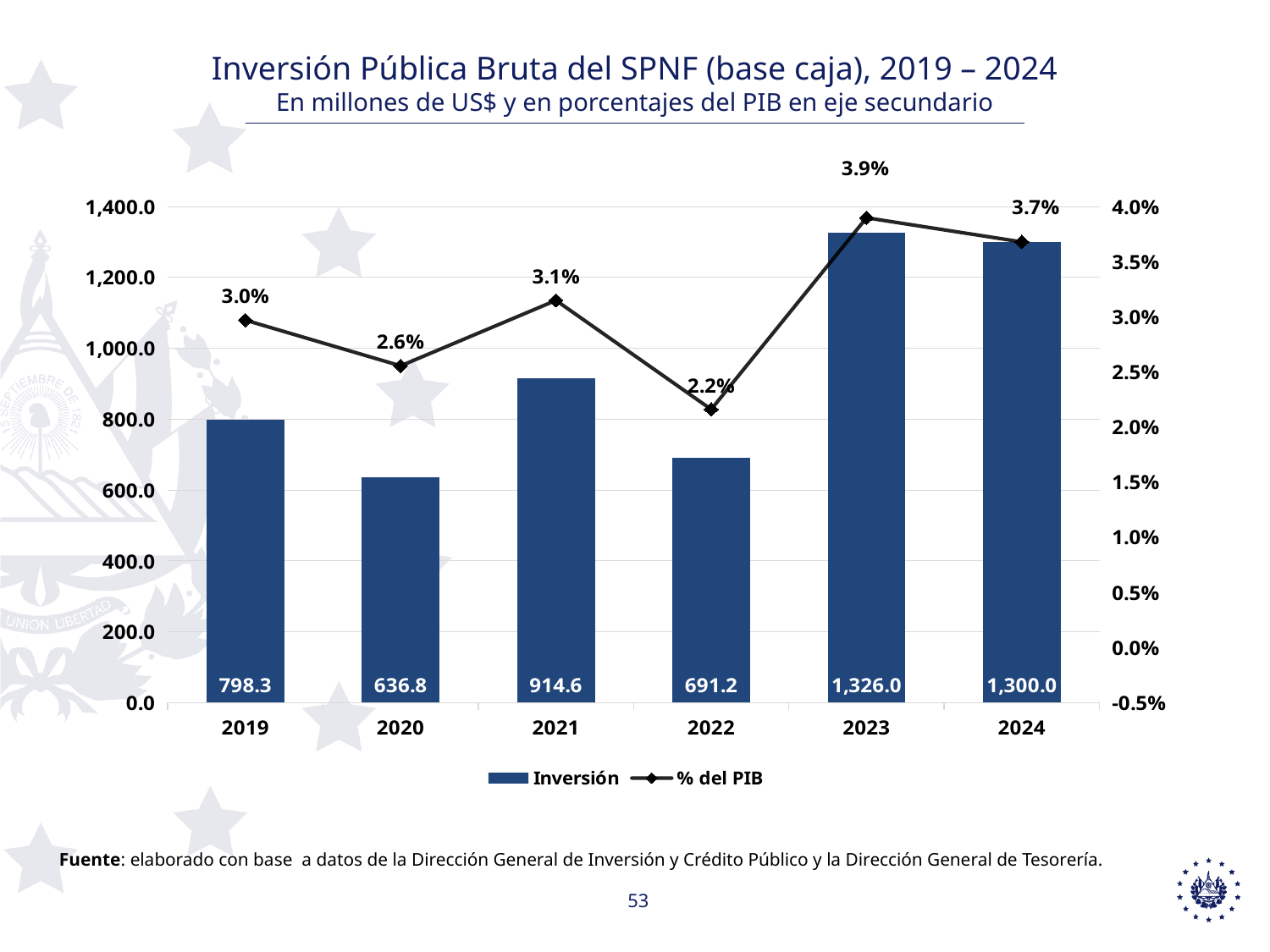
What is the difference between the Inversión values for 2023 and 2024? 26.0 How many series does the legend list? 2 Which year has the lowest % del PIB value? 2022 How many years are shown on the x axis? 6 What is the title of the chart? Inversión Pública Bruta del SPNF (base caja), 2019 – 2024 What is the % del PIB value for 2022? 2.2% What is the Inversión value for 2021? 914.6 What kind of chart is used for the Inversión series? bar chart Does the % del PIB value rise or fall from 2022 to 2023? rise Which year has the highest Inversión value? 2023 Which is larger, the Inversión value for 2019 or for 2022? 2019 Is the Inversión value for 2020 greater or less than 800.0? less